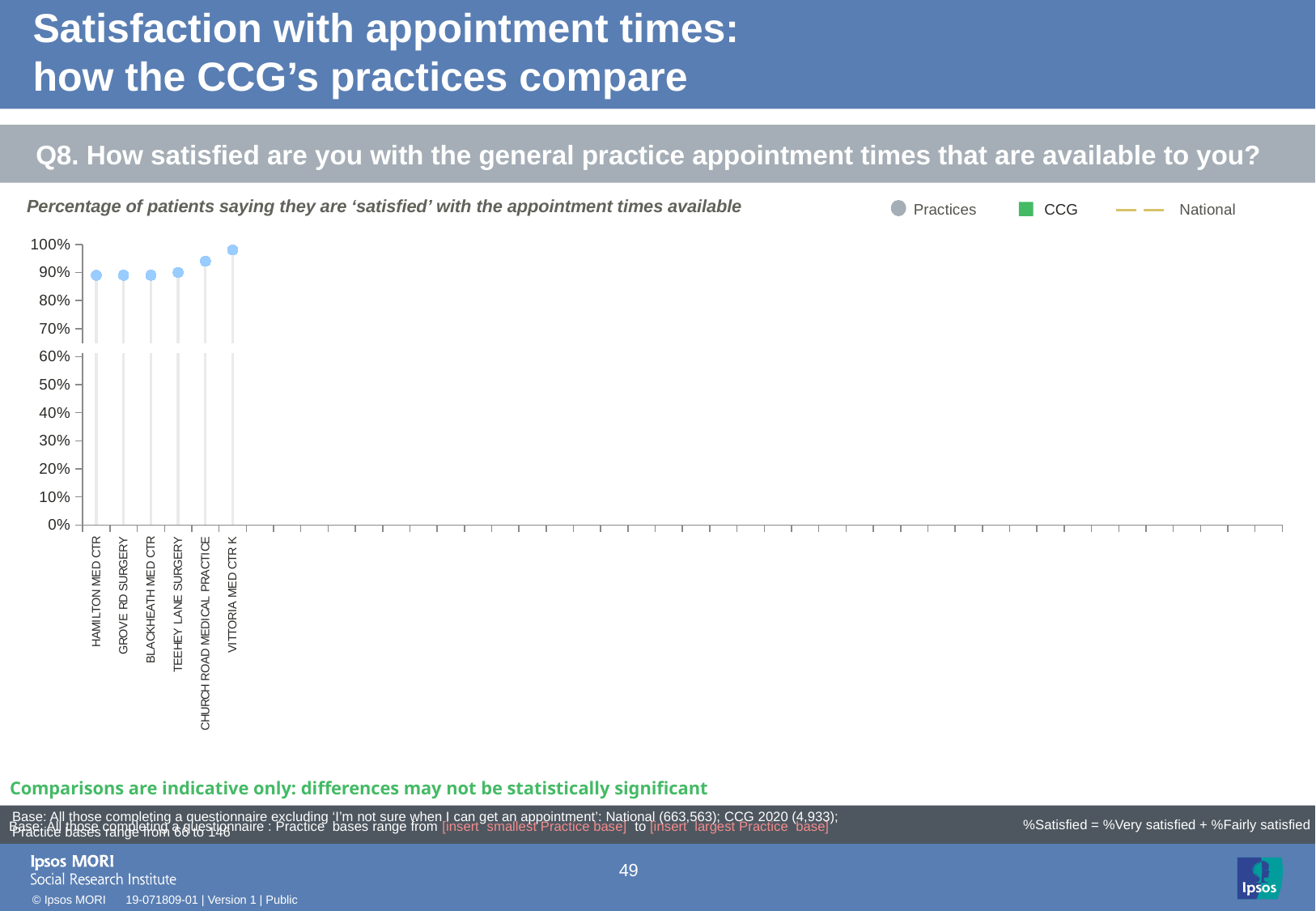
Which practice has the highest percentage of patients satisfied with appointment times? VITTORIA MED CTR K Is the value for CHURCH ROAD MEDICAL PRACTICE greater or less than 90%? greater Which has the larger value, CHURCH ROAD MEDICAL PRACTICE or BLACKHEATH MED CTR? CHURCH ROAD MEDICAL PRACTICE Is the value for VITTORIA MED CTR K greater or less than 90%? greater Do the plotted values rise or fall moving from left to right along the x axis? rise Which has the larger value, VITTORIA MED CTR K or HAMILTON MED CTR? VITTORIA MED CTR K How many series does the legend list? 3 How many practices are plotted on the chart? 6 What does the chart's subtitle say is being plotted? Percentage of patients saying they are 'satisfied' with the appointment times available Is the value for GROVE RD SURGERY greater or less than 70%? greater What are the three entries in the chart legend? Practices, CCG, National